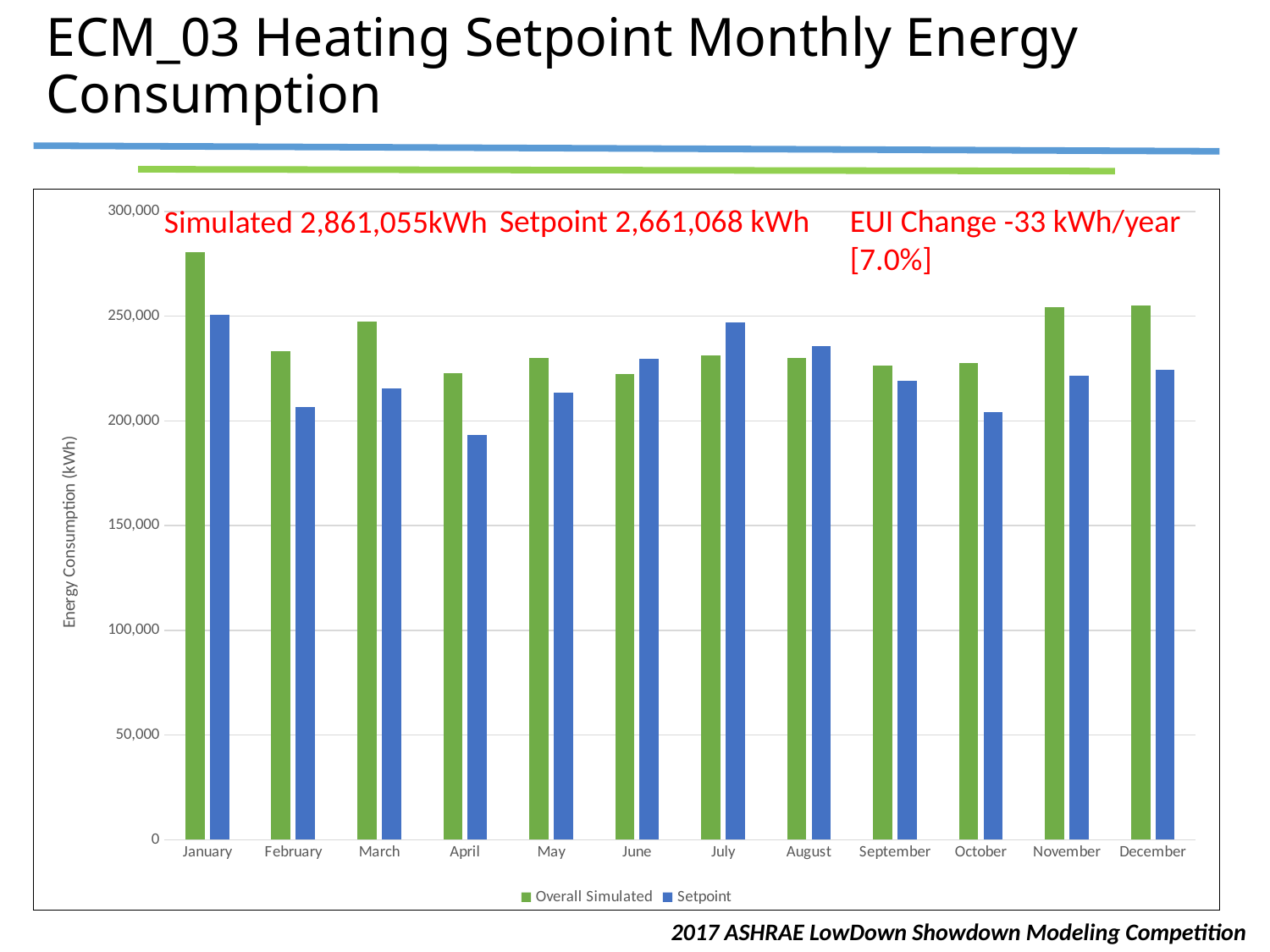
In July, which is larger: Overall Simulated or Setpoint? Setpoint In January, which is larger: Overall Simulated or Setpoint? Overall Simulated Which month has the lowest Setpoint value? April What kind of chart is shown on the slide? bar chart How many series does the legend list? 2 Which month has the highest Overall Simulated value? January Is the Overall Simulated value for February greater or less than 250,000? less How many months are shown on the x axis? 12 What is the label on the y axis? Energy Consumption (kWh) What are the two series named in the legend? Overall Simulated and Setpoint Is the Setpoint value for April greater or less than 200,000? less Is the Overall Simulated value for January greater or less than 250,000? greater